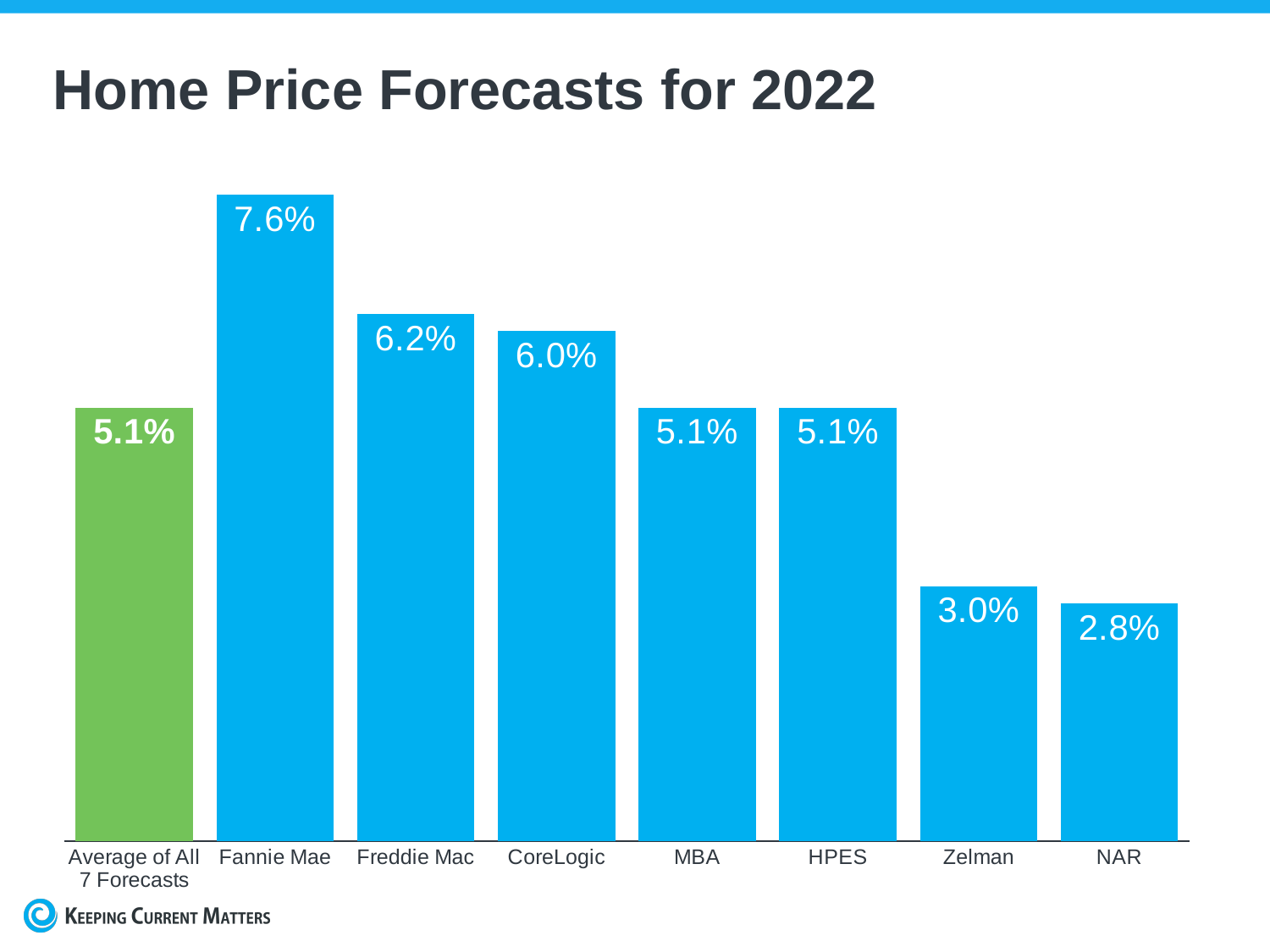
What is the forecast value for NAR? 2.8% What is the home price forecast for 2022 from Fannie Mae? 7.6% What is the difference between the Fannie Mae forecast and the Freddie Mac forecast? 1.4% How many bars are shown in the chart? 8 Which forecaster has the highest home price forecast for 2022? Fannie Mae What is the value shown for the Average of All 7 Forecasts? 5.1% What type of chart is shown on the slide? Bar chart What is the forecast value for Zelman? 3.0% Which bar is shown in green rather than blue? Average of All 7 Forecasts Which is larger, the Freddie Mac forecast or the CoreLogic forecast? Freddie Mac What is the difference between the CoreLogic forecast and the NAR forecast? 3.2% Which forecaster has the lowest home price forecast for 2022? NAR